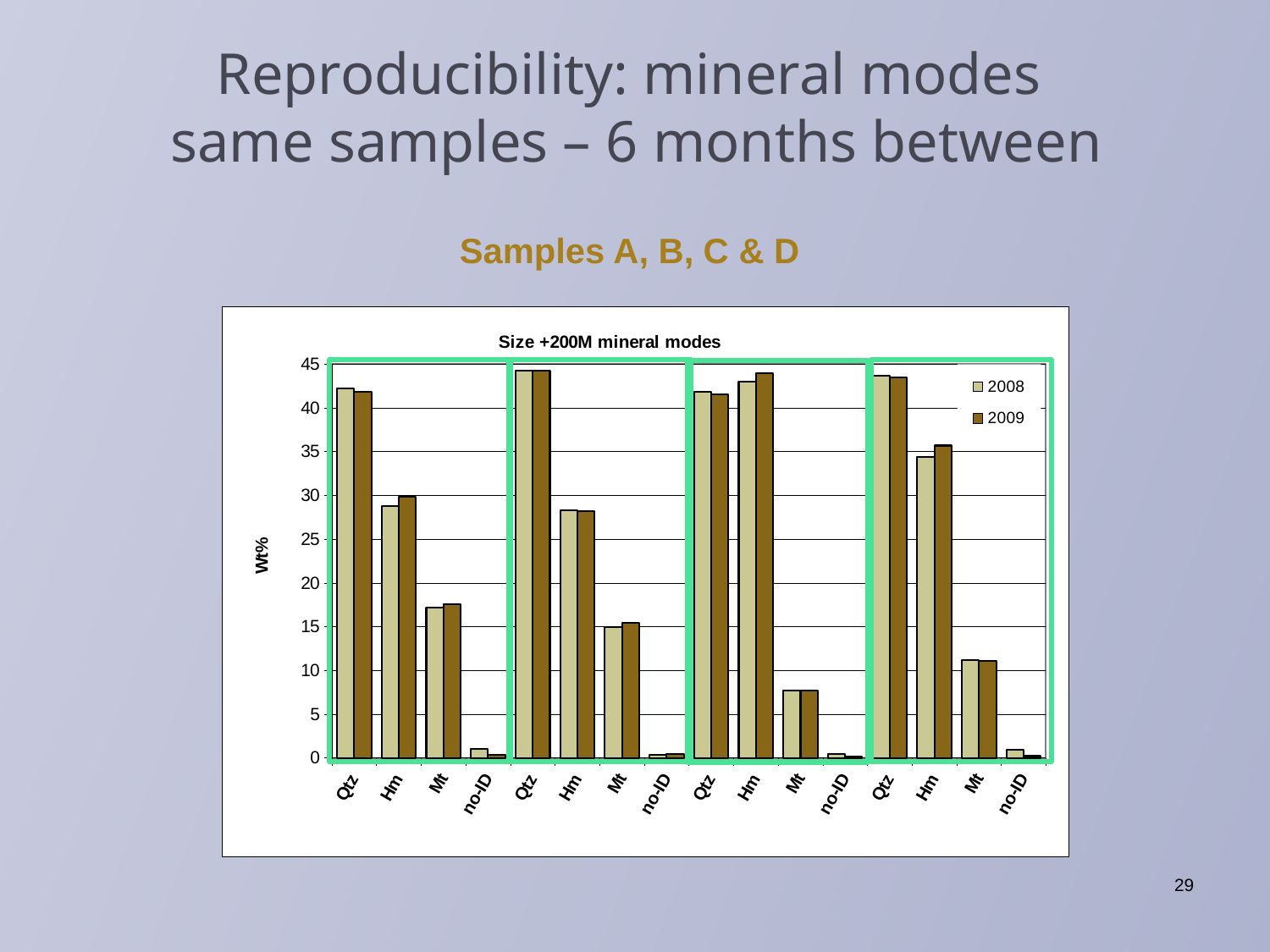
What is the title printed above the chart? Size +200M mineral modes In the fourth (rightmost) group of bars, is the 2008 value for Mt greater or less than 10? greater In the first (leftmost) group of bars, which has the larger 2009 value, Qtz or Hm? Qtz How many series does the legend of the chart list? 2 How many category labels are shown along the x axis of the chart? 16 What kind of chart is shown on the slide? bar chart In the first (leftmost) group of bars, is the 2008 value for Hm greater or less than 25? greater In the first (leftmost) group of bars, is the 2008 value for Qtz greater or less than 40? greater Which mineral category has the lowest bars in every group of the chart? no-ID What are the two series named in the chart legend? 2008 and 2009